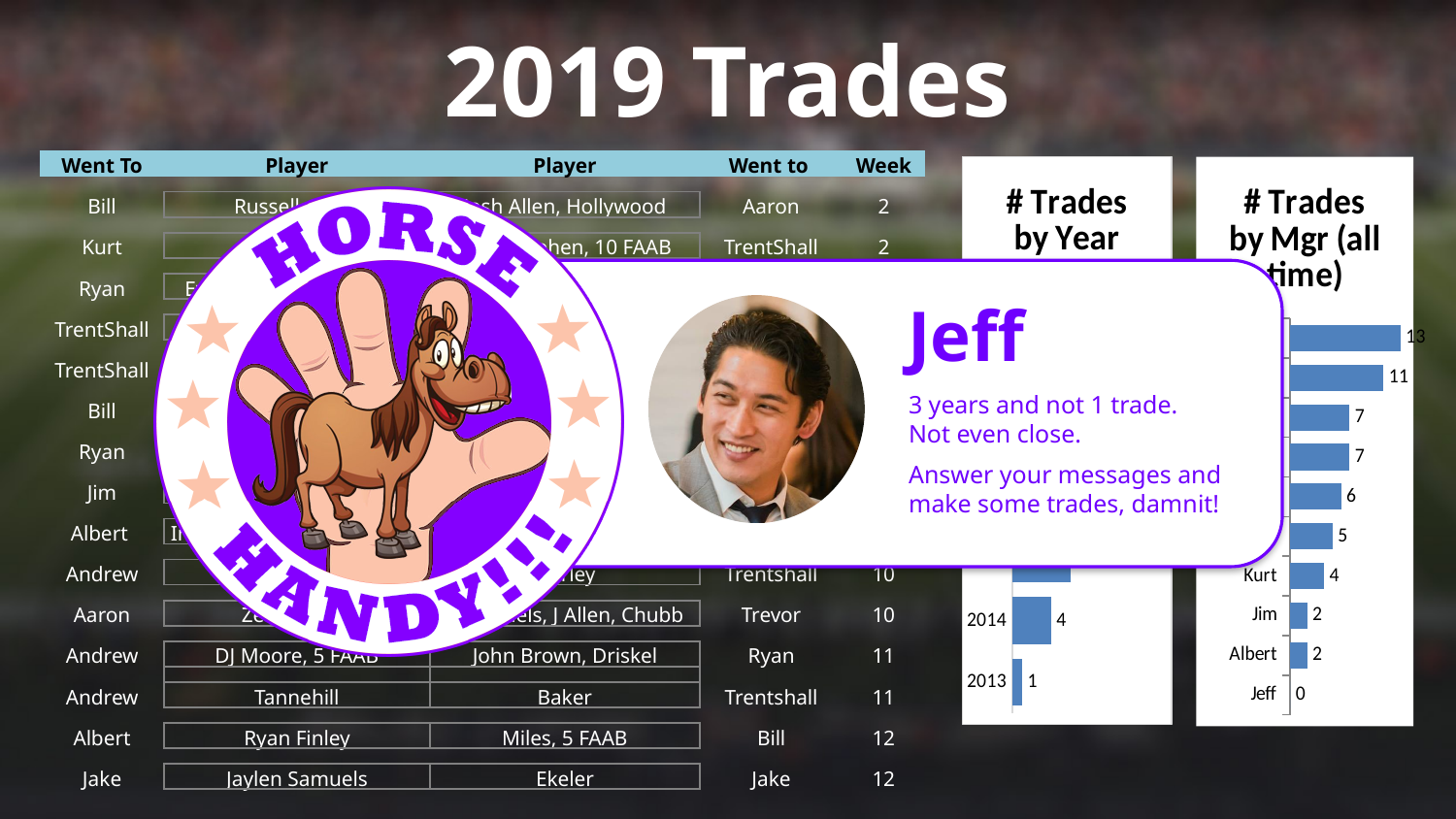
In the '# Trades by Year' chart, how many trades were made in 2014? 4 In the '# Trades by Mgr (all time)' chart, how many trades does Jeff have? 0 What type of chart is the '# Trades by Year' chart? Bar chart In the '# Trades by Mgr (all time)' chart, which manager has the fewest trades? Jeff In the '# Trades by Mgr (all time)' chart, what is the value for Albert? 2 In the '# Trades by Year' chart, how many trades were made in 2013? 1 In the '# Trades by Year' chart, what is the difference between the 2014 and 2013 values? 3 In the '# Trades by Mgr (all time)' chart, what is the largest value labeled on any bar? 13 In the '# Trades by Mgr (all time)' chart, what is the value for Jim? 2 In the '# Trades by Mgr (all time)' chart, who has more trades, Kurt or Jim? Kurt In the '# Trades by Mgr (all time)' chart, how many more trades does Kurt have than Albert? 2 In the '# Trades by Mgr (all time)' chart, how many trades does Kurt have? 4